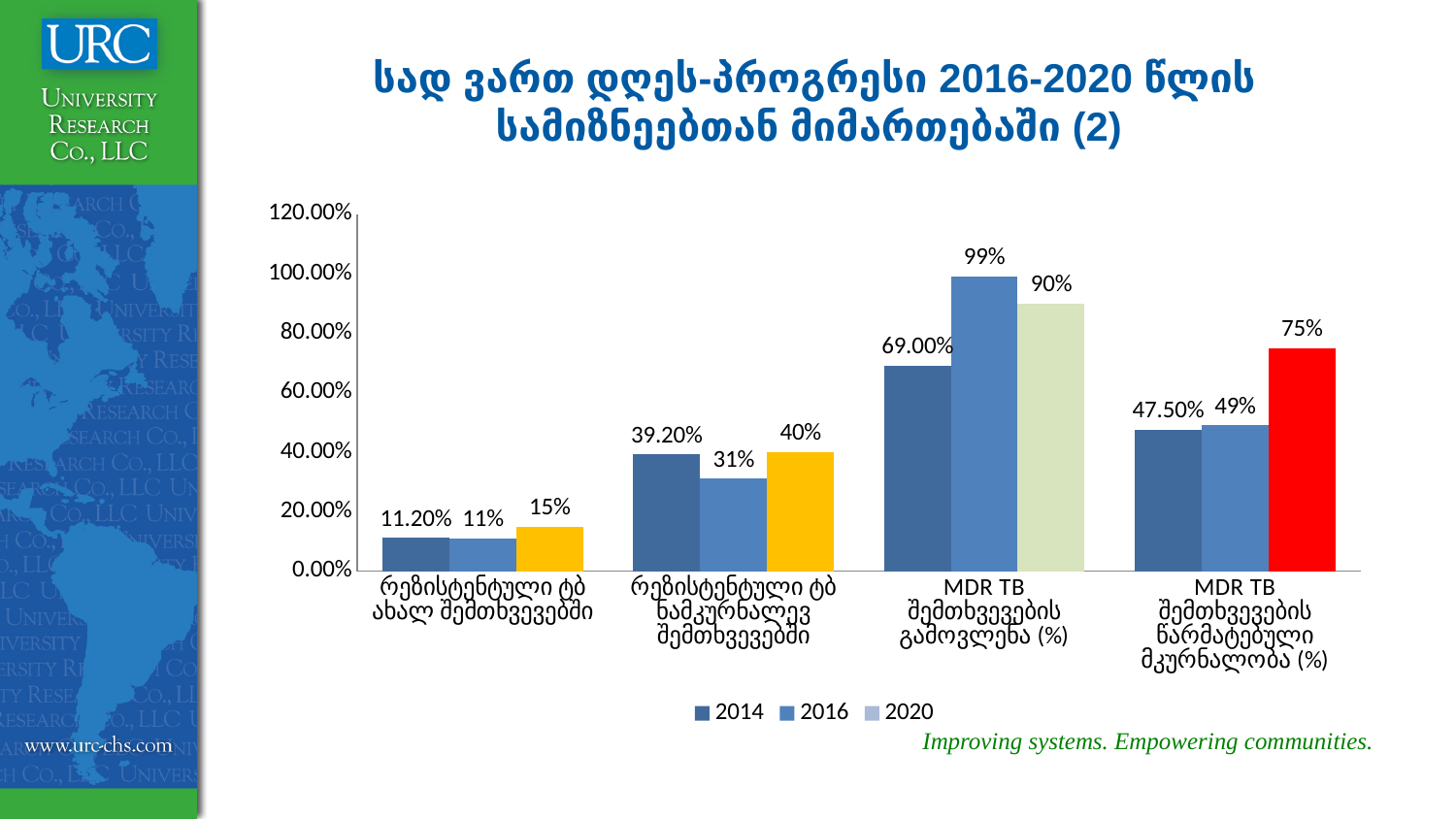
What is the 2016 value for რეზისტენტული ტბ ნამკურნალევ შემთხვევებში? 31% How many series does the legend list? 3 What is the 2020 value for MDR TB შემთხვევების წარმატებული მკურნალობა (%)? 75% For MDR TB შემთხვევების გამოვლენა (%), which is larger: the 2016 value or the 2020 value? 2016 How many categories are shown on the x axis? 4 Which series is shown in the legend first? 2014 Which category has the highest 2016 value? MDR TB შემთხვევების გამოვლენა (%) What is the 2014 value for რეზისტენტული ტბ ახალ შემთხვევებში? 11.20% Which category has the lowest 2020 value? რეზისტენტული ტბ ახალ შემთხვევებში What kind of chart is shown on the slide? bar chart What is the 2016 value for MDR TB შემთხვევების გამოვლენა (%)? 99% What is the difference between the 2020 and 2014 values for MDR TB შემთხვევების წარმატებული მკურნალობა (%)? 27.50%